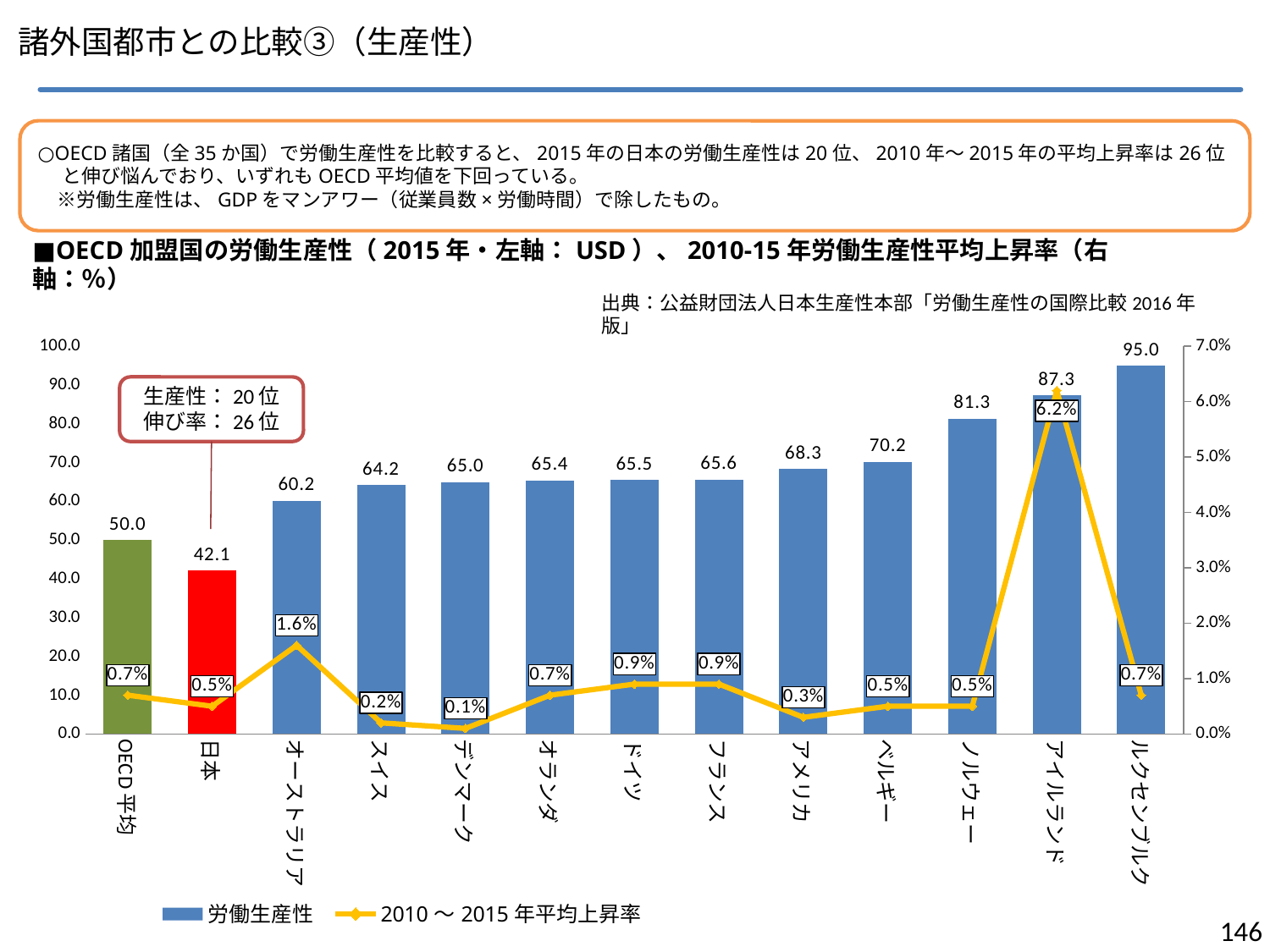
What is the labour productivity (労働生産性) value shown for 日本? 42.1 What is the difference between the labour productivity of OECD平均 and 日本? 7.9 What is the 2010～2015年平均上昇率 value shown for デンマーク? 0.1% How many categories are shown on the x axis of the chart? 13 How many series does the legend list? 2 Which has a higher labour productivity value, アメリカ or ベルギー? ベルギー Which category has the lowest labour productivity bar? 日本 What is the labour productivity value shown for ルクセンブルク? 95.0 What kind of chart is shown on the slide? Combined bar and line chart Which category has the highest 2010～2015年平均上昇率 value? アイルランド What is the 2010～2015年平均上昇率 value shown for アイルランド? 6.2% Which category has the highest labour productivity bar? ルクセンブルク